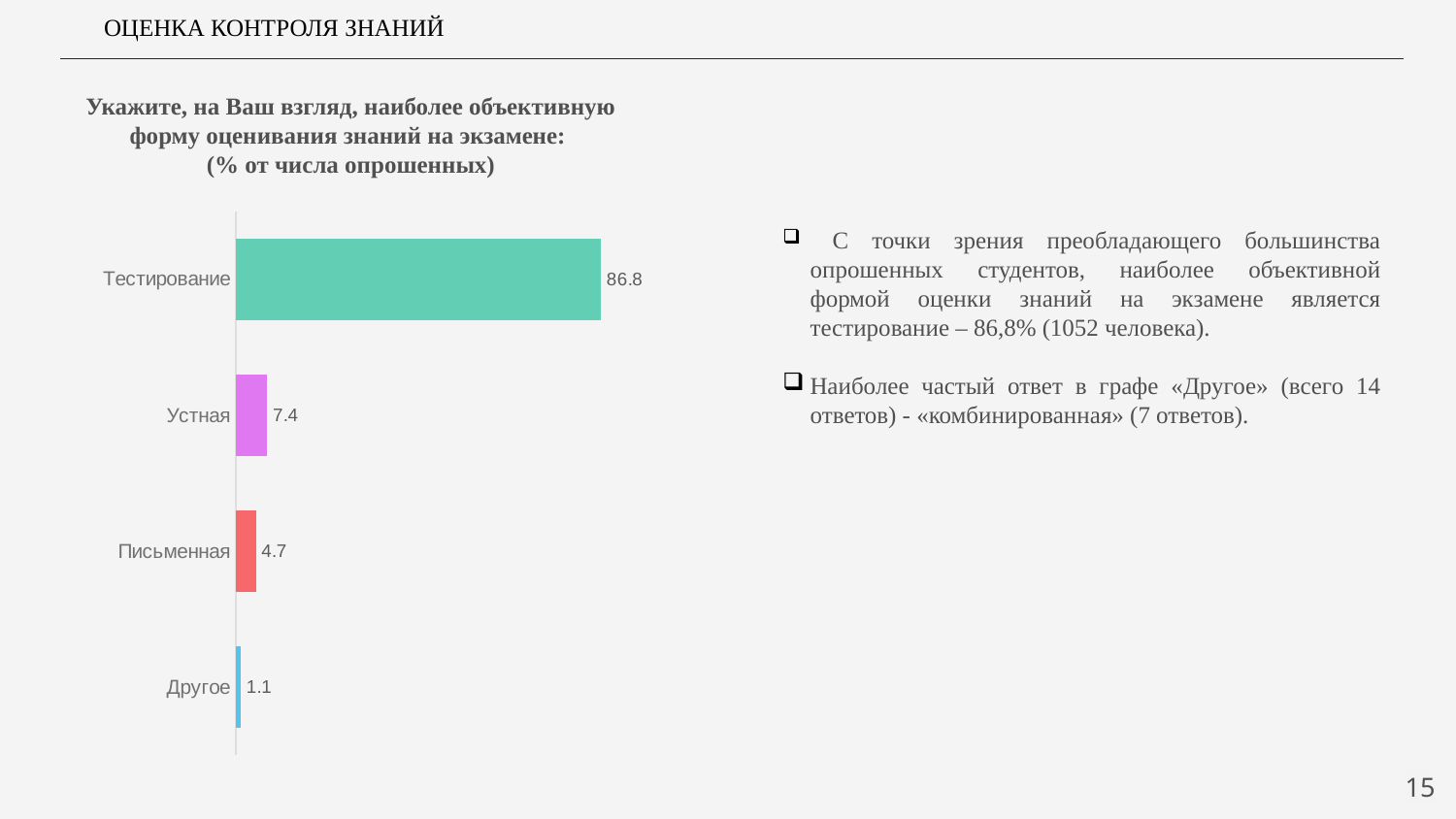
What is the value for Устная? 7.4 What is the value for Письменная? 4.7 Which category has the highest value? Тестирование How many categories are shown in the chart? 4 What colour is the bar for Тестирование? Green What kind of chart is shown on the slide? Bar chart Which category has the lowest value? Другое Which is larger, the value for Письменная or the value for Другое? Письменная What is the difference between the values for Устная and Письменная? 2.7 What is the value for Другое? 1.1 What is the value for Тестирование? 86.8 What is the difference between the values for Тестирование and Устная? 79.4